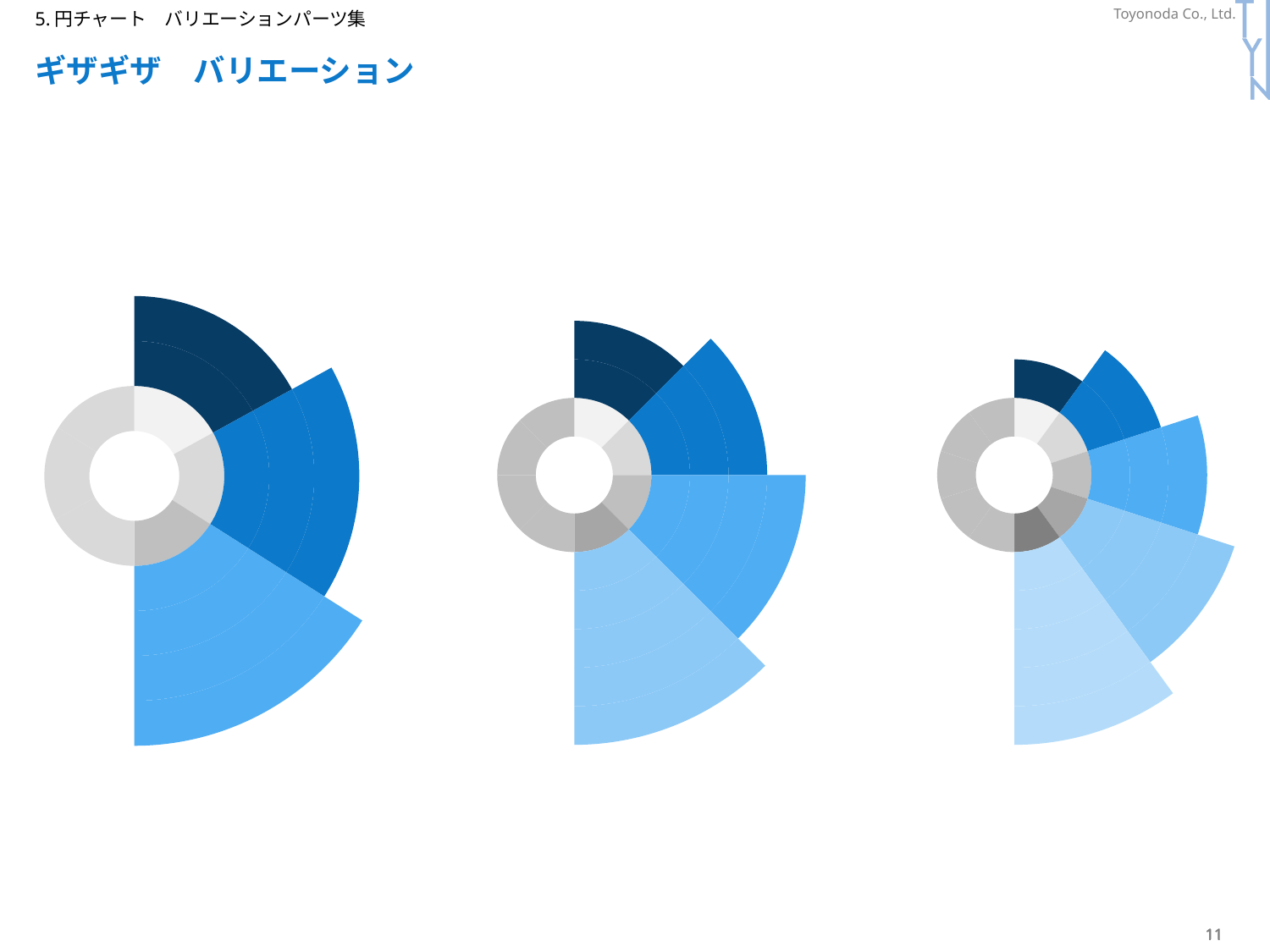
In the left chart, which blue segment extends farthest from the center: the top, middle, or bottom one? bottom In the middle chart, how many blue segments are there? 4 What is the title of the slide? ギザギザ バリエーション In the left chart, how many blue segments are there? 3 Do any of the charts on the slide show a legend? no In the right chart, which blue segment extends farthest from the center: the top (darkest) or the bottom (lightest) one? bottom In the middle chart, does the bottom (lightest blue) segment extend farther from the center than the top (dark navy) segment? yes In the right chart, how many blue segments are there? 5 In the left chart, which blue segment extends least from the center: the top, middle, or bottom one? top According to the slide header, what kind of chart are these variations of? pie chart